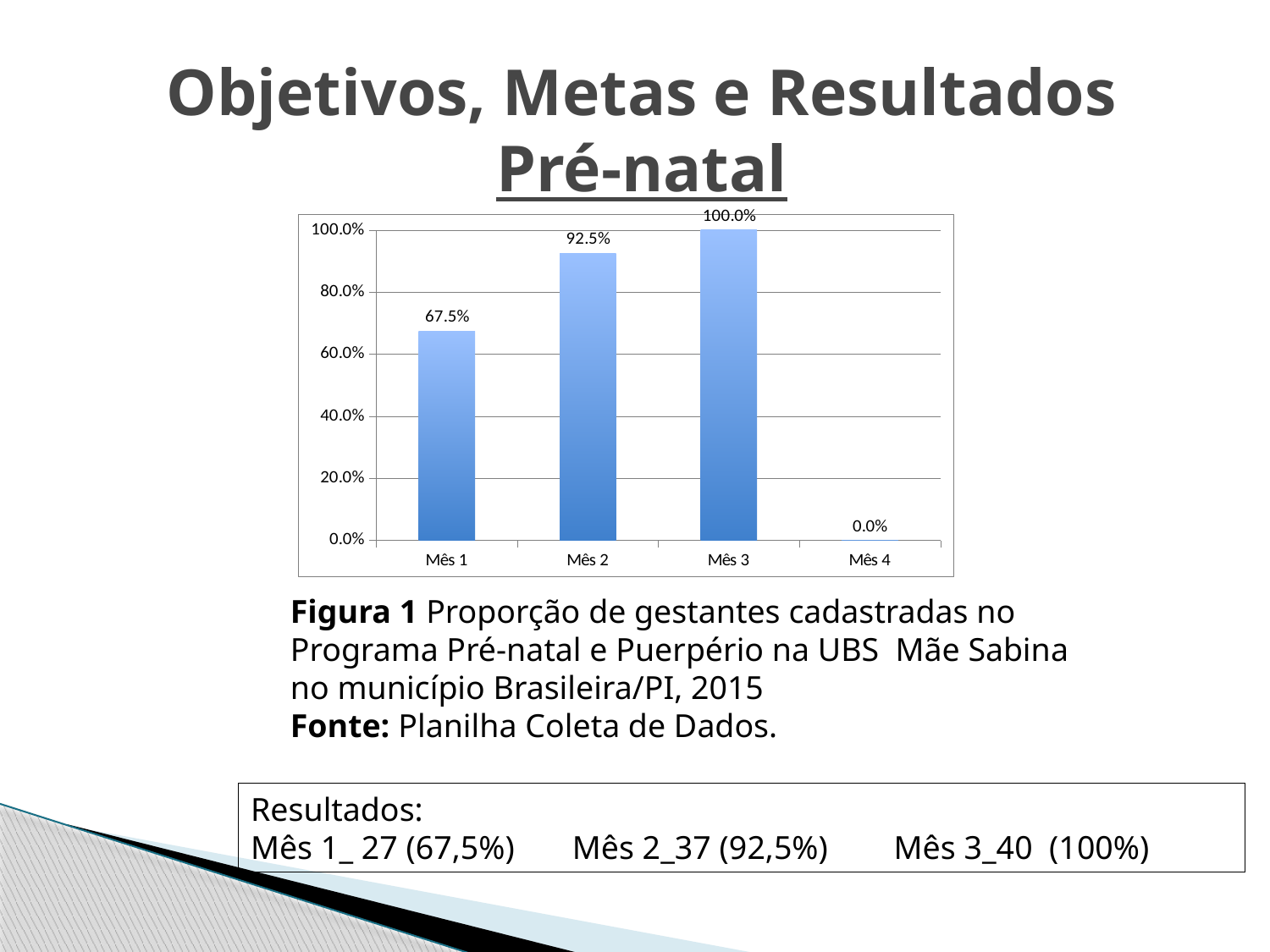
What is the value for Mês 2? 92.5% Is the value for Mês 1 greater or less than 60.0%? greater Which month has the lowest value? Mês 4 Which month has the highest value? Mês 3 Which is larger, the value for Mês 1 or the value for Mês 2? Mês 2 What is the value for Mês 3? 100.0% What is the value for Mês 4? 0.0% What is the value for Mês 1? 67.5% How many months are shown on the x axis? 4 What kind of chart is shown on the slide? bar chart What is the difference between the values for Mês 2 and Mês 1? 25.0% Do the values rise or fall from Mês 1 to Mês 3? rise